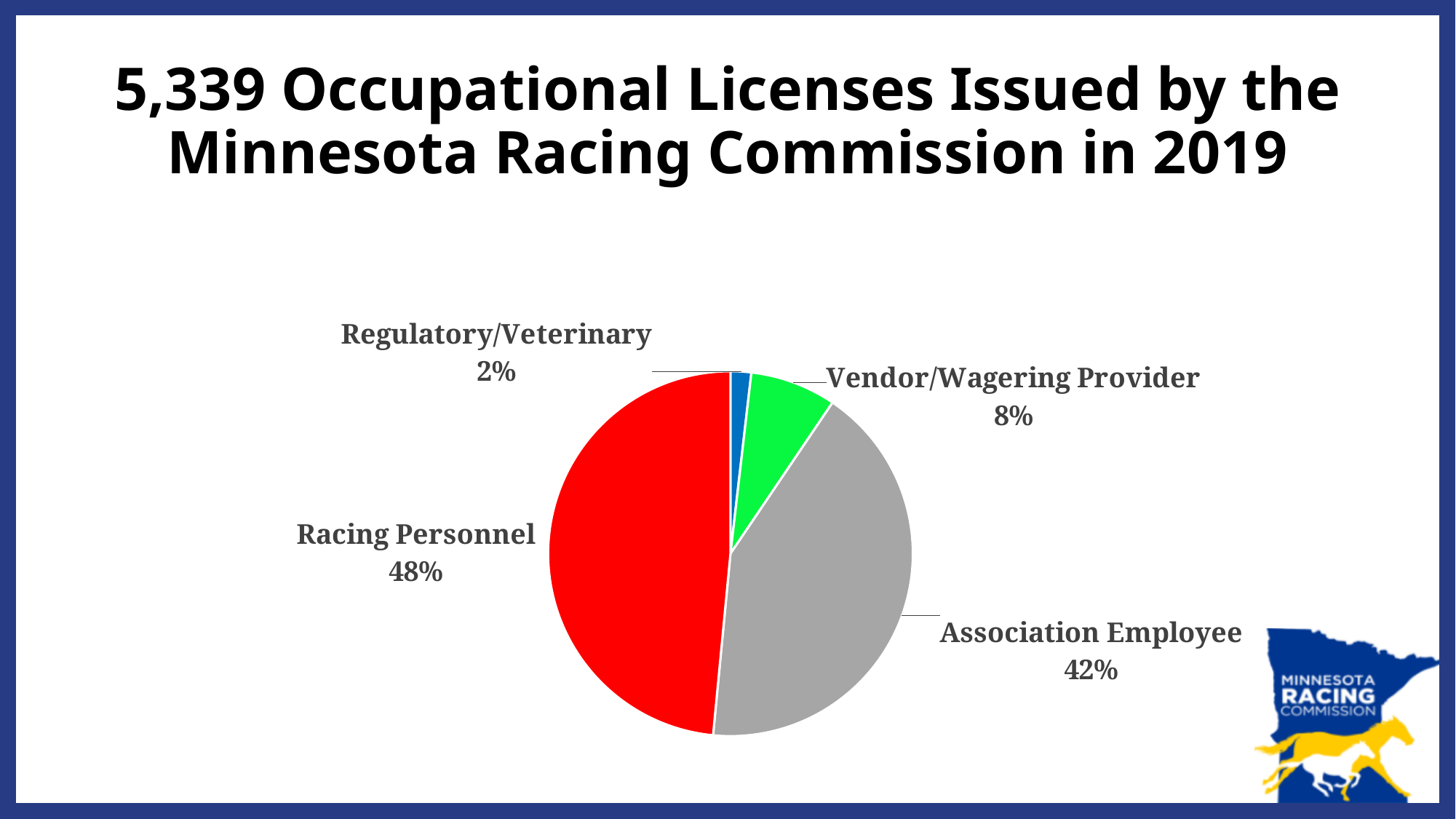
What share of the pie does Association Employee represent? 42% Which category has the smallest slice of the pie? Regulatory/Veterinary What share of the pie does Regulatory/Veterinary represent? 2% Which category has the largest slice of the pie? Racing Personnel What is the title of the slide? 5,339 Occupational Licenses Issued by the Minnesota Racing Commission in 2019 What share of the pie does Racing Personnel represent? 48% What is the difference in percentage points between Vendor/Wagering Provider and Regulatory/Veterinary? 6 How many categories are shown in the pie chart? 4 What kind of chart is shown on the slide? Pie chart What is the difference in percentage points between Racing Personnel and Association Employee? 6 Which is larger, the share for Vendor/Wagering Provider or the share for Regulatory/Veterinary? Vendor/Wagering Provider